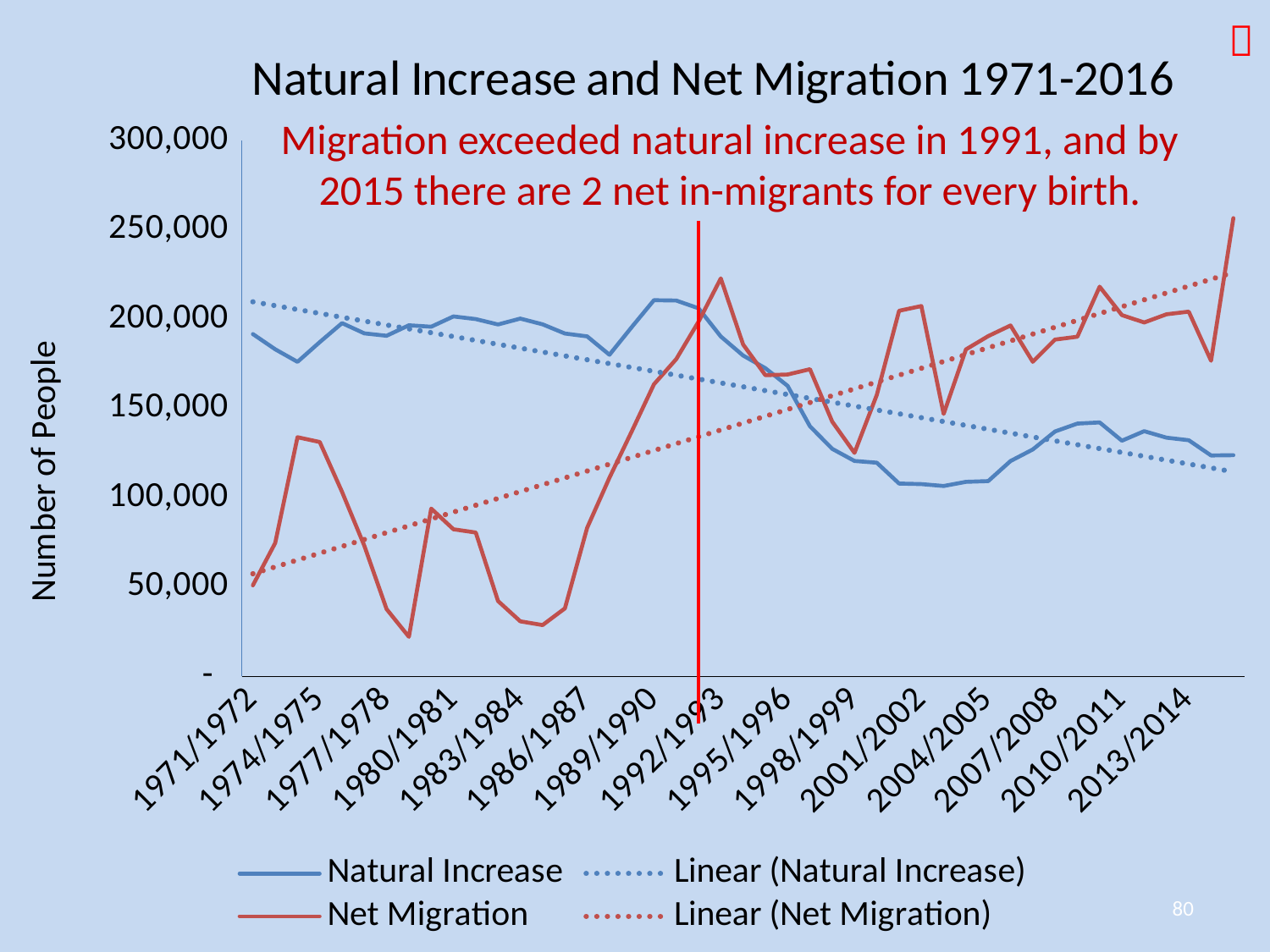
In 1971/1972, which is larger: Natural Increase or Net Migration? Natural Increase What is the title of the chart? Natural Increase and Net Migration 1971-2016 What kind of chart is shown on the slide? Line chart In 2013/2014, which is larger: Natural Increase or Net Migration? Net Migration Is the value for Net Migration in 1992/1993 greater or less than 200,000? greater Is the value for Net Migration in 1980/1981 greater or less than 50,000? greater How many series does the legend list? 4 Does the Linear (Natural Increase) trendline rise or fall from left to right? Fall What is the label on the vertical axis? Number of People How many year labels are shown on the x axis? 15 Is the value for Natural Increase in 2001/2002 greater or less than 150,000? less